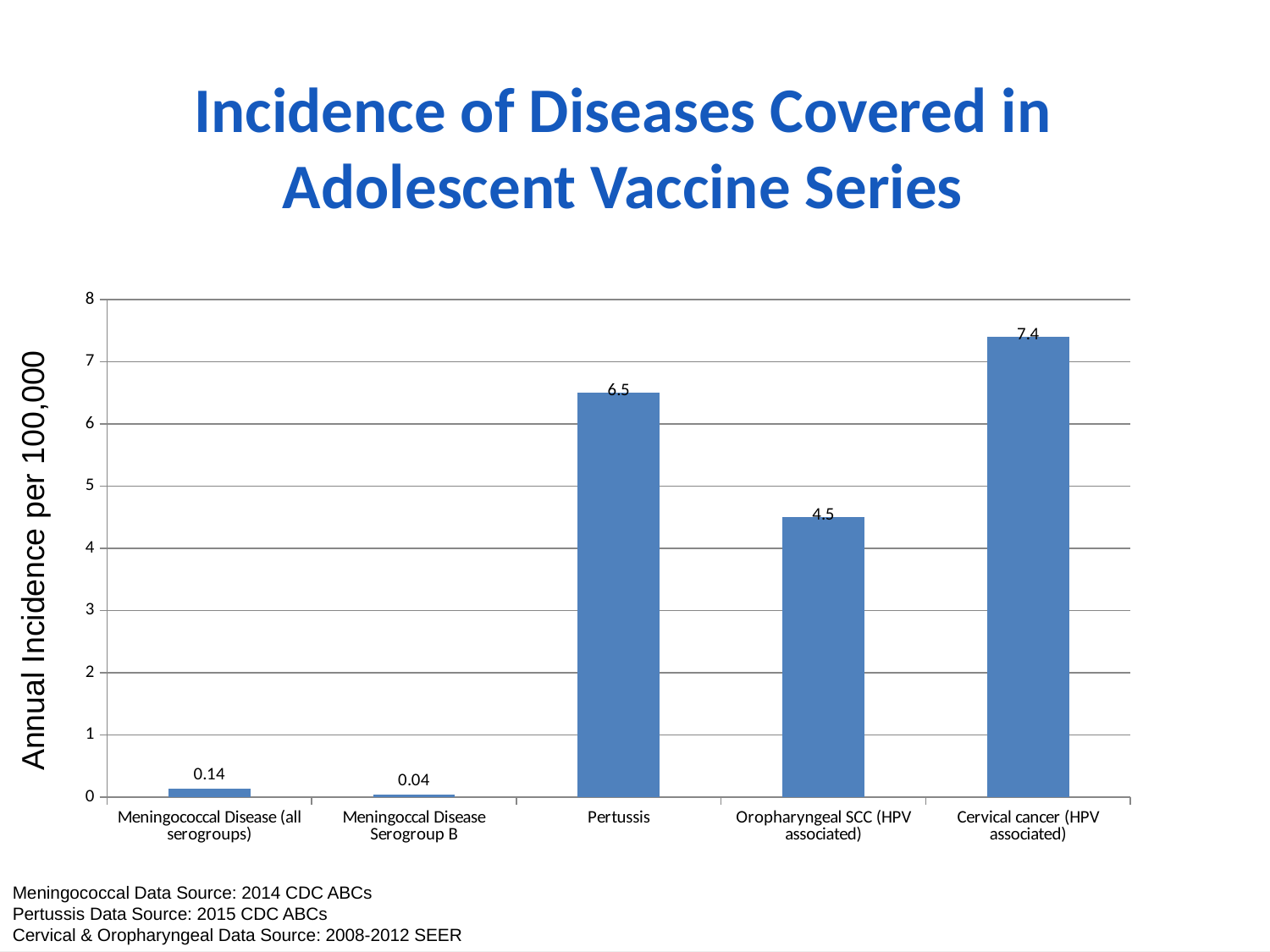
Which has a higher annual incidence per 100,000, Pertussis or Oropharyngeal SCC (HPV associated)? Pertussis What is the annual incidence per 100,000 for Cervical cancer (HPV associated)? 7.4 What is the difference in annual incidence per 100,000 between Cervical cancer (HPV associated) and Pertussis? 0.9 Which disease has the highest annual incidence per 100,000? Cervical cancer (HPV associated) Is the value for Oropharyngeal SCC (HPV associated) greater or less than 5? less Which disease has the lowest annual incidence per 100,000? Meningoccal Disease Serogroup B What is the annual incidence per 100,000 for Meningococcal Disease (all serogroups)? 0.14 What kind of chart is shown on the slide? Bar chart What is the title of the chart on the slide? Incidence of Diseases Covered in Adolescent Vaccine Series What is the annual incidence per 100,000 for Pertussis? 6.5 What is the annual incidence per 100,000 for Oropharyngeal SCC (HPV associated)? 4.5 How many disease categories are shown on the chart? 5